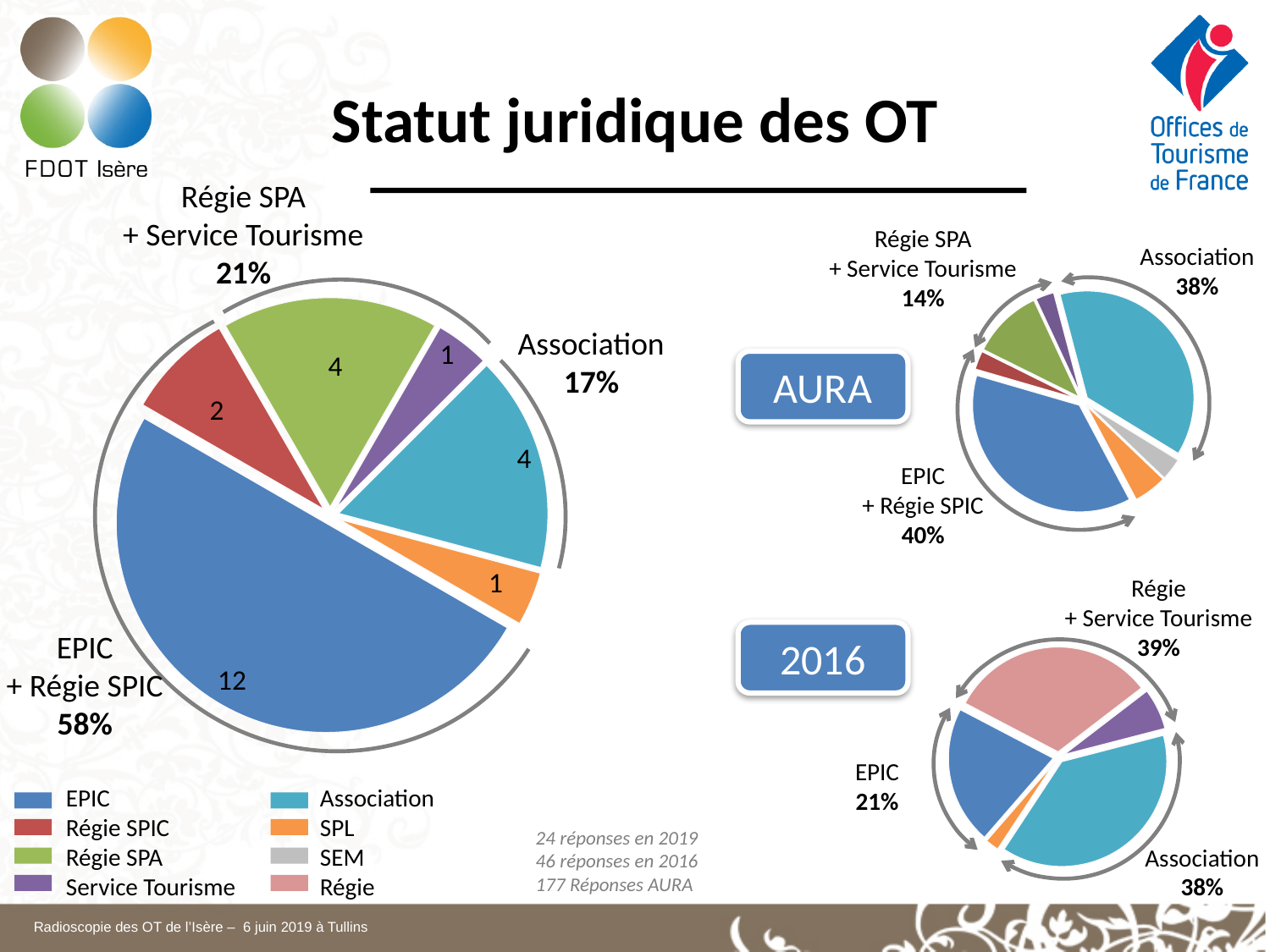
On the large pie chart on the left, which category has the largest slice? EPIC How many entries does the legend at the bottom left of the slide list? 8 On the large pie chart on the left, which is larger, the Régie SPA slice or the Régie SPIC slice? Régie SPA On the AURA pie chart, what share is labelled for EPIC + Régie SPIC? 40% On the large pie chart on the left, what is the value for Régie SPA? 4 On the large pie chart on the left, what is the value for Régie SPIC? 2 On the large pie chart on the left, what share is labelled for Association? 17% On the large pie chart on the left, what share is labelled for EPIC + Régie SPIC? 58% On the large pie chart on the left, what is the difference between the EPIC value and the Association value? 8 On the large pie chart on the left, what is the value for EPIC? 12